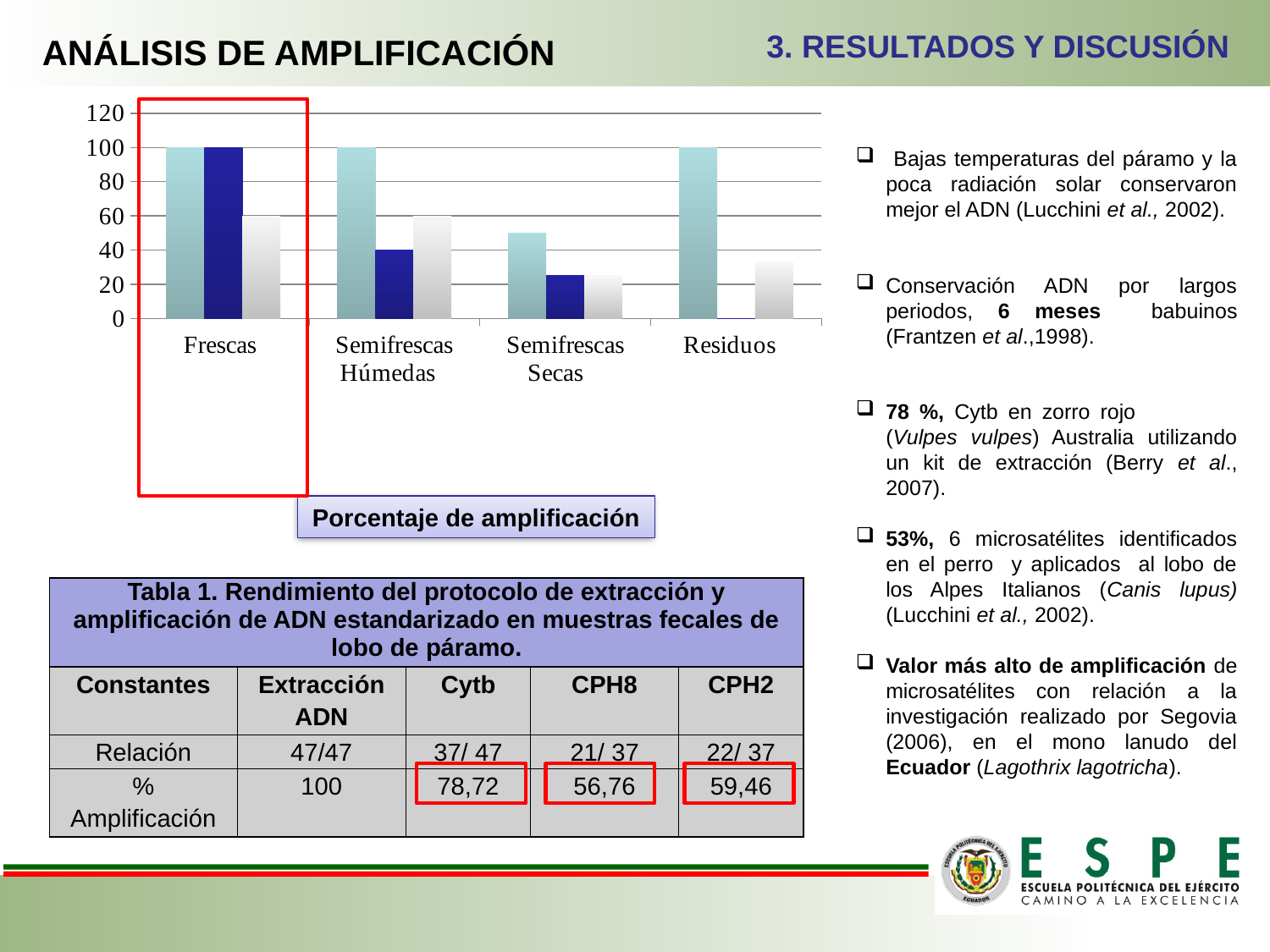
Is the value of the light teal bar for Semifrescas Secas greater or less than 60? less What is the value of the dark blue bar for Semifrescas Húmedas? 40 What kind of chart is shown on the slide? bar chart What is the value of the grey bar for Frescas? 60 What is the value of the light teal bar for Residuos? 100 Is the value of the dark blue bar for Semifrescas Secas greater or less than 40? less Do the dark blue bars rise or fall from Frescas to Residuos? fall What is the value of the light teal bar for Frescas? 100 What is the caption shown below the chart? Porcentaje de amplificación What is the value of the dark blue bar for Frescas? 100 Which category has the lowest value for the light teal bars? Semifrescas Secas How many categories are shown on the x axis of the chart? 4